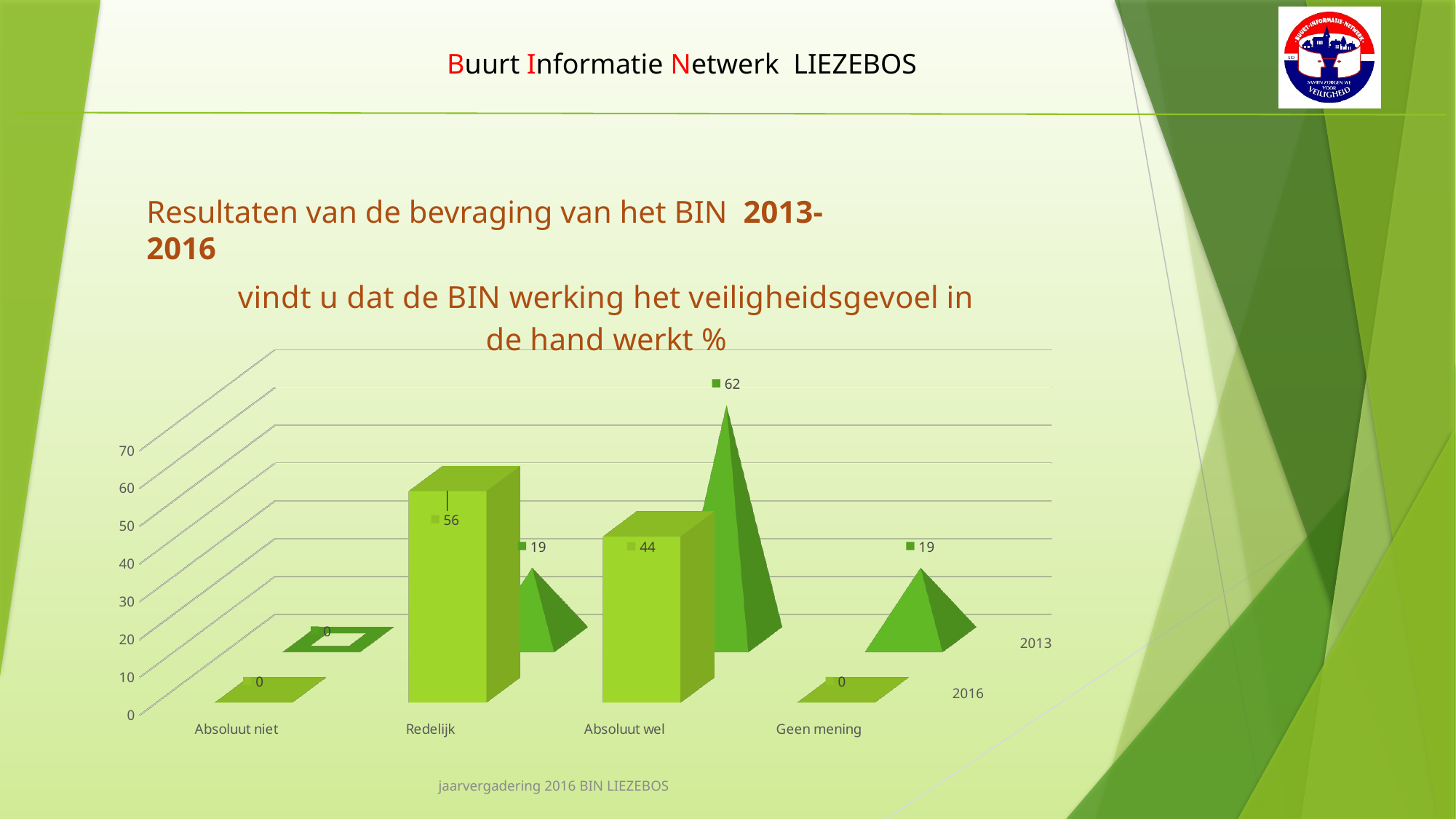
How many categories are shown on the x axis? 4 What is the value for Geen mening in the 2013 series? 19 What is the value for Absoluut wel in the 2016 series? 44 What is the difference between the 2013 and 2016 values for Absoluut wel? 18 What type of chart is shown on the slide? Bar chart What is the difference between the 2016 values for Redelijk and Absoluut wel? 12 Which category has the highest value in the 2016 series? Redelijk What is the value for Redelijk in the 2016 series? 56 Which category has the highest value in the 2013 series? Absoluut wel What is the value for Absoluut wel in the 2013 series? 62 How many data series does the chart show? 2 Which is larger for Redelijk: the 2013 value or the 2016 value? 2016